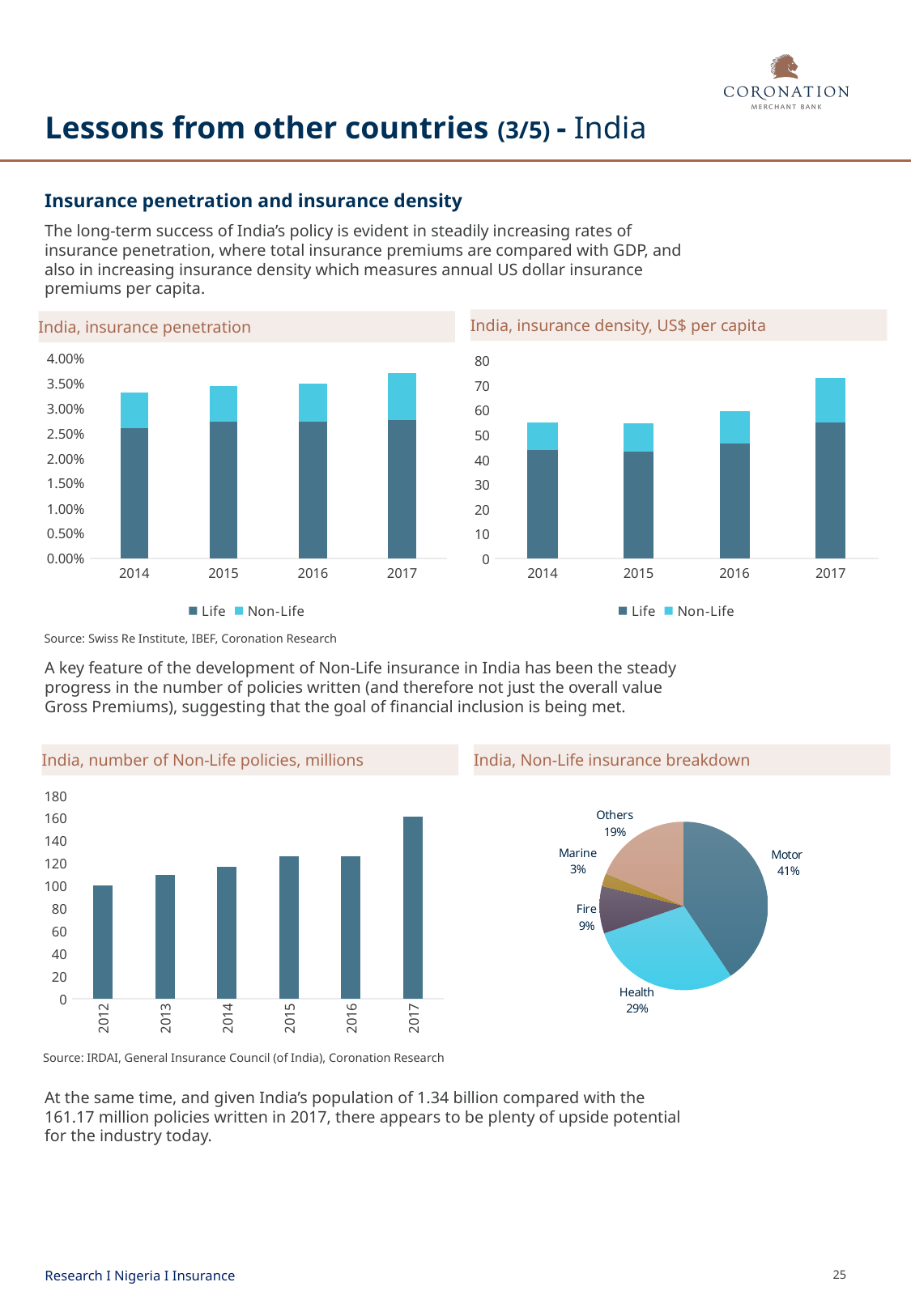
In the 'India, number of Non-Life policies, millions' chart, do the values rise or fall from 2012 to 2017? Rise In the 'India, number of Non-Life policies, millions' chart, how many years are shown? 6 In the 'India, Non-Life insurance breakdown' pie chart, how many percentage points larger is Motor than Health? 12% In the 'India, Non-Life insurance breakdown' pie chart, what share does Motor have? 41% In the 'India, insurance density, US$ per capita' chart, is the total stacked value for 2017 greater or less than 70? greater In the 'India, insurance penetration' chart, which year has the highest total stacked bar? 2017 In the 'India, Non-Life insurance breakdown' pie chart, which category has the largest slice? Motor In the 'India, Non-Life insurance breakdown' pie chart, which category has the smallest slice? Marine In the 'India, number of Non-Life policies, millions' chart, is the value for 2017 greater or less than 140? greater What kind of chart is 'India, number of Non-Life policies, millions'? Bar chart In the 'India, insurance density, US$ per capita' chart, how many series does the legend list? 2 In the 'India, Non-Life insurance breakdown' pie chart, how many slices are there? 5